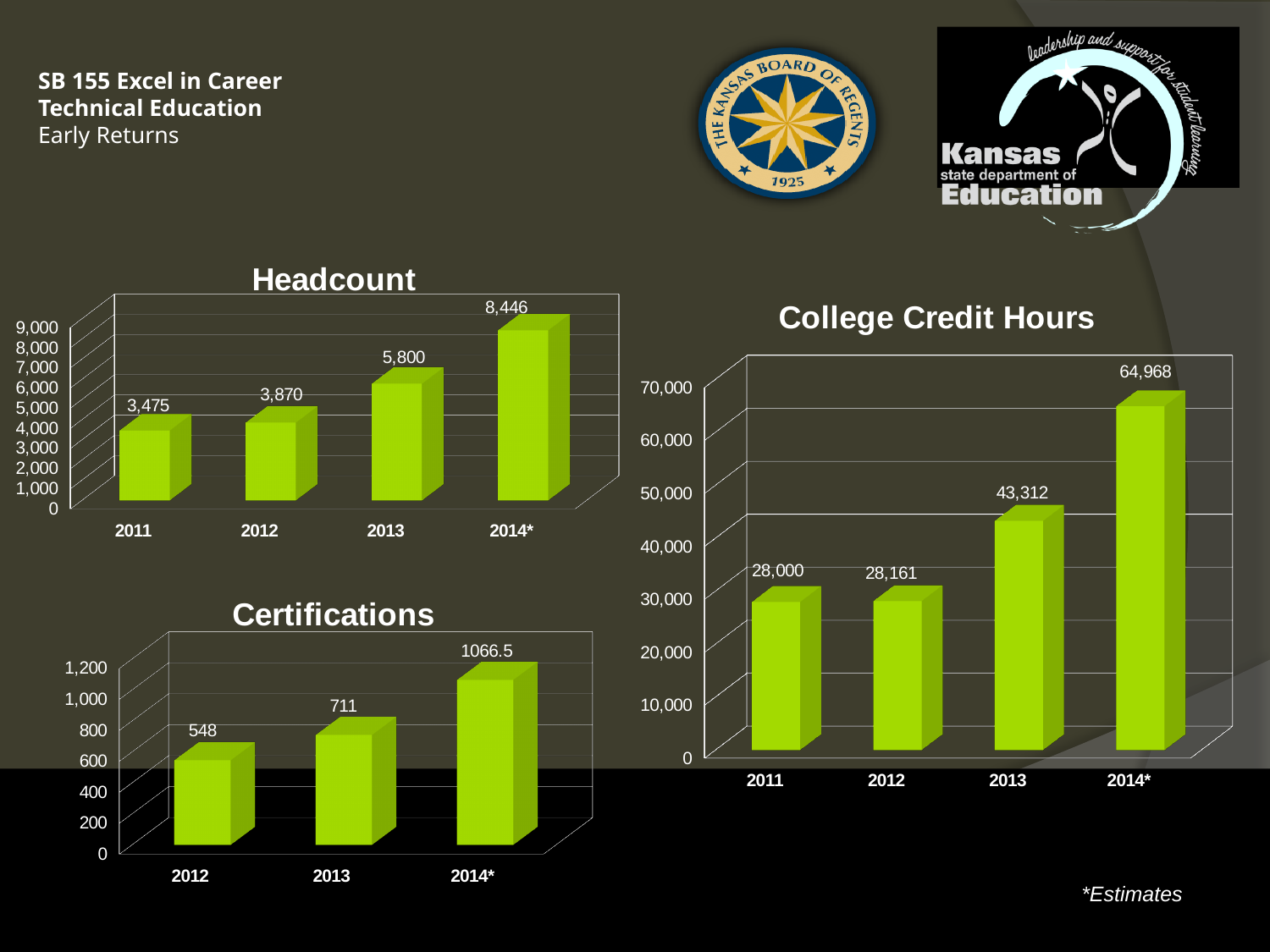
In the Headcount chart, what is the value for 2013? 5,800 In the Certifications chart, how many years are shown on the x axis? 3 What kind of chart is the College Credit Hours chart? bar chart In the Headcount chart, which year has the highest value? 2014* In the Headcount chart, what is the difference between the 2014* and 2011 values? 4,971 In the Certifications chart, which year has the lowest value? 2012 In the Certifications chart, what is the difference between the 2013 and 2012 values? 163 In the College Credit Hours chart, which is larger, the value for 2013 or the value for 2014*? 2014* In the Headcount chart, how many years are shown on the x axis? 4 In the College Credit Hours chart, what is the value for 2013? 43,312 In the Certifications chart, what is the value for 2012? 548 In the College Credit Hours chart, do the values rise or fall from 2011 to 2014*? rise